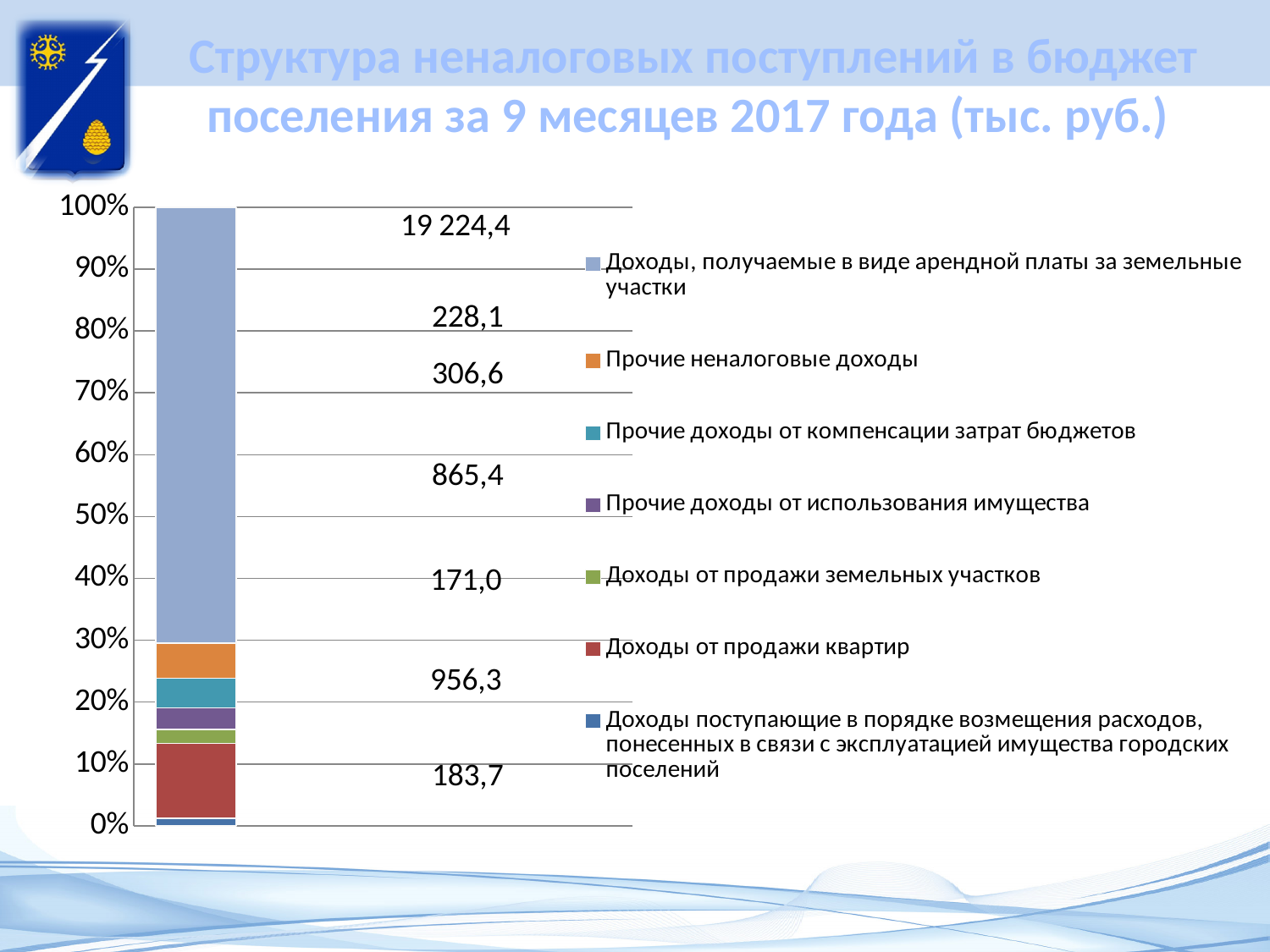
Which series has the largest labelled value? Доходы, получаемые в виде арендной платы за земельные участки How many bars are plotted in the chart? 1 What is the value labelled for 'Прочие доходы от использования имущества'? 865,4 What kind of chart is shown on the slide? Stacked bar chart What is the value labelled for 'Доходы от продажи квартир'? 956,3 How many series does the legend list? 7 What is the difference between the labelled values for 'Доходы от продажи квартир' and 'Прочие доходы от использования имущества'? 90,9 Which series has the smallest labelled value? Доходы от продажи земельных участков What is the value labelled for 'Доходы, получаемые в виде арендной платы за земельные участки'? 19 224,4 What is the value labelled for 'Прочие неналоговые доходы'? 228,1 What is the title of the chart on the slide? Структура неналоговых поступлений в бюджет поселения за 9 месяцев 2017 года (тыс. руб.) What is the value labelled for 'Прочие доходы от компенсации затрат бюджетов'? 306,6